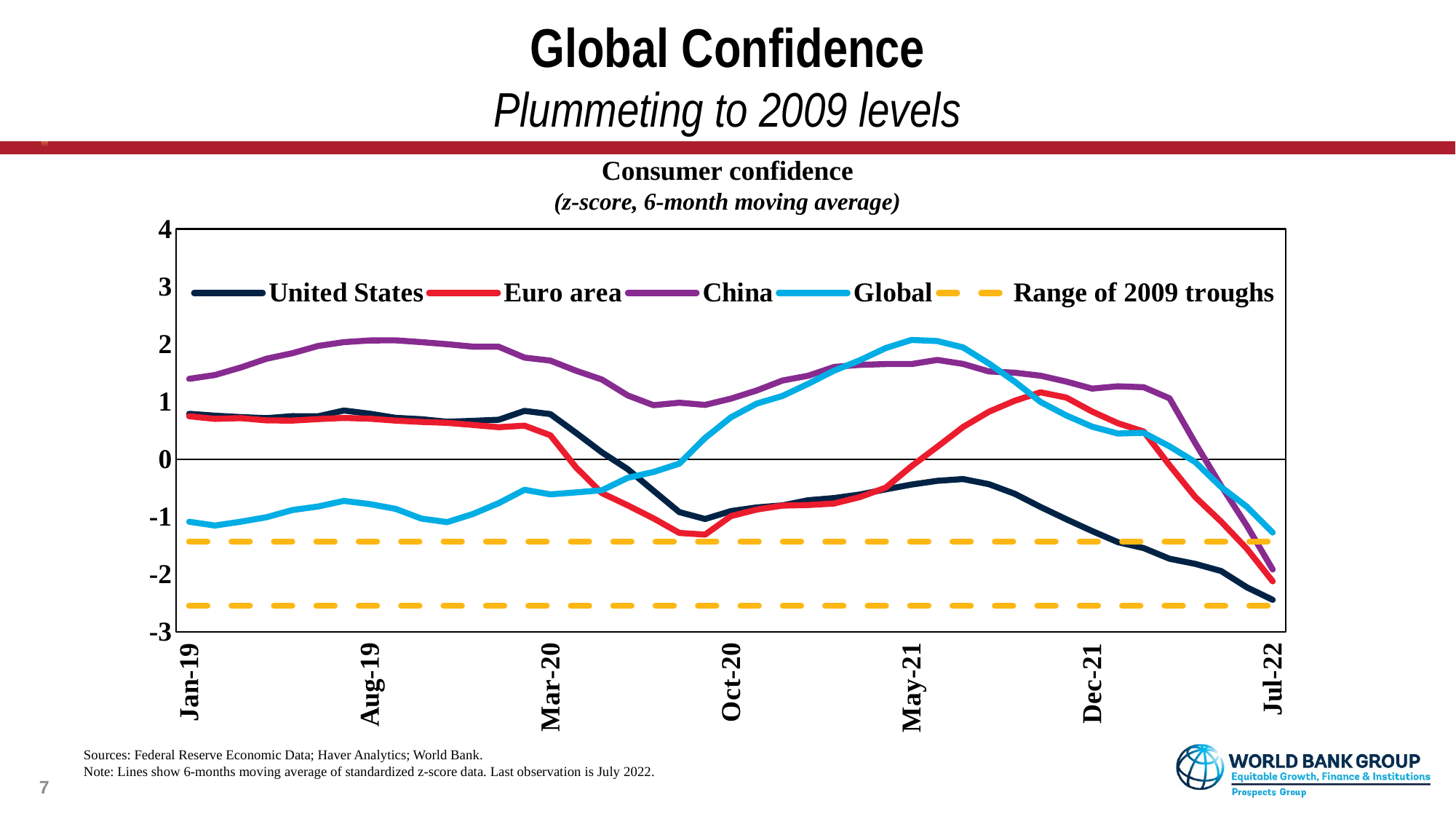
What is the title of the chart? Consumer confidence How many date labels are shown on the x axis? 7 Is the value for Global at May-21 greater or less than 1? greater Does the United States line rise or fall overall from Jan-19 to Jul-22? fall At Oct-20, which is larger: the Global value or the United States value? Global Which series has the lowest value at Jan-19? Global Which series has the highest value at Jan-19? China Is the value for China at Jan-19 greater or less than 1? greater Is the value for United States at Jul-22 greater or less than -2? less Which series has the lowest value at Jul-22? United States How many series does the chart legend list? 5 What kind of chart is shown on the slide? line chart